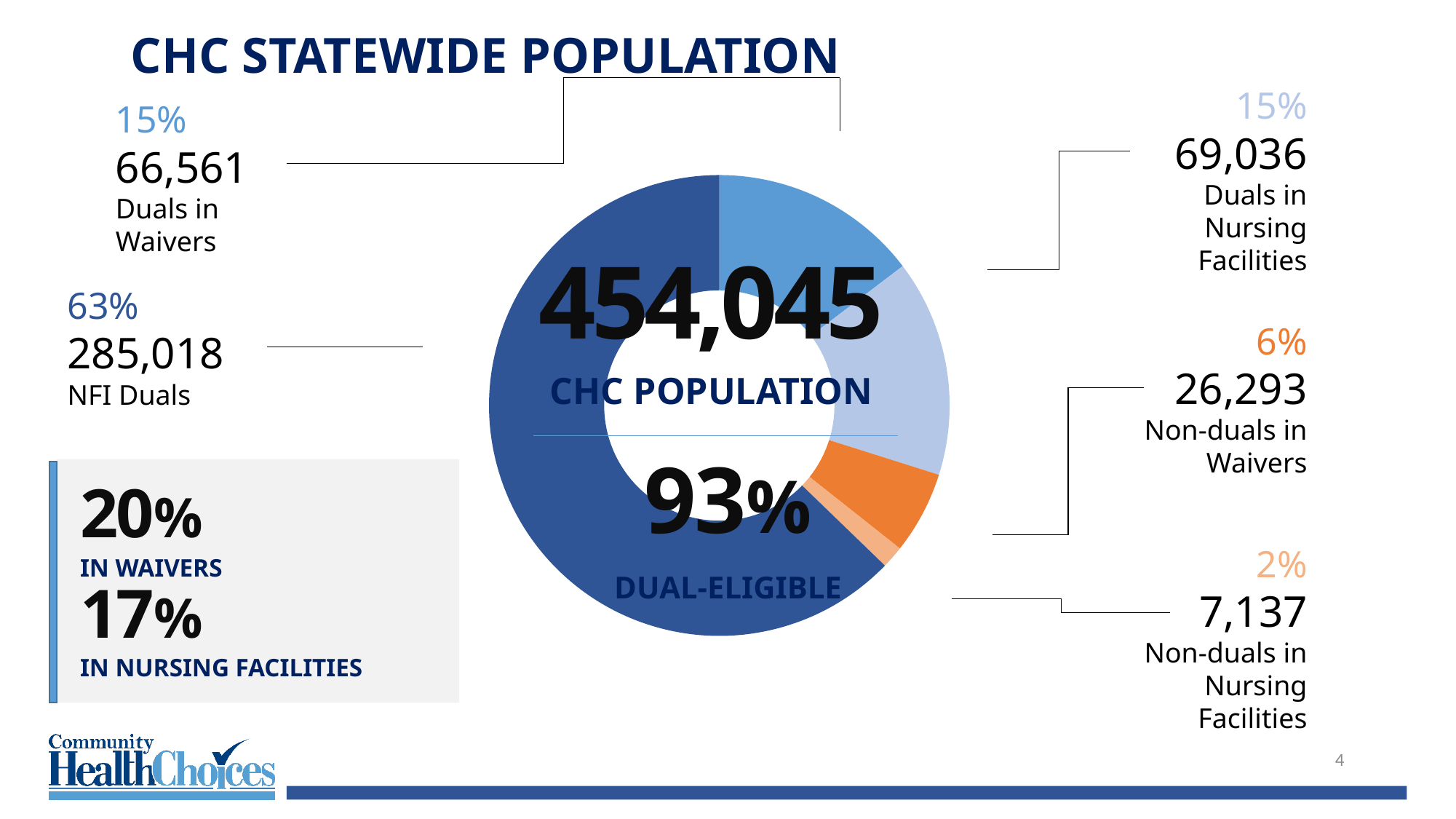
How many Duals in Nursing Facilities are there? 69,036 How many segments does the donut chart have? 5 Which segment of the chart is the smallest? Non-duals in Nursing Facilities What percentage of the CHC population is dual-eligible, according to the centre of the chart? 93% What kind of chart is shown on the slide? Donut (pie) chart What share of the CHC population is NFI Duals? 63% How many NFI Duals are there? 285,018 What is the difference between the number of Duals in Nursing Facilities and Duals in Waivers? 2,475 How many Non-duals in Nursing Facilities are there? 7,137 Which segment of the chart is the largest? NFI Duals What is the total CHC population shown in the centre of the chart? 454,045 What share of the CHC population is Non-duals in Waivers? 6%